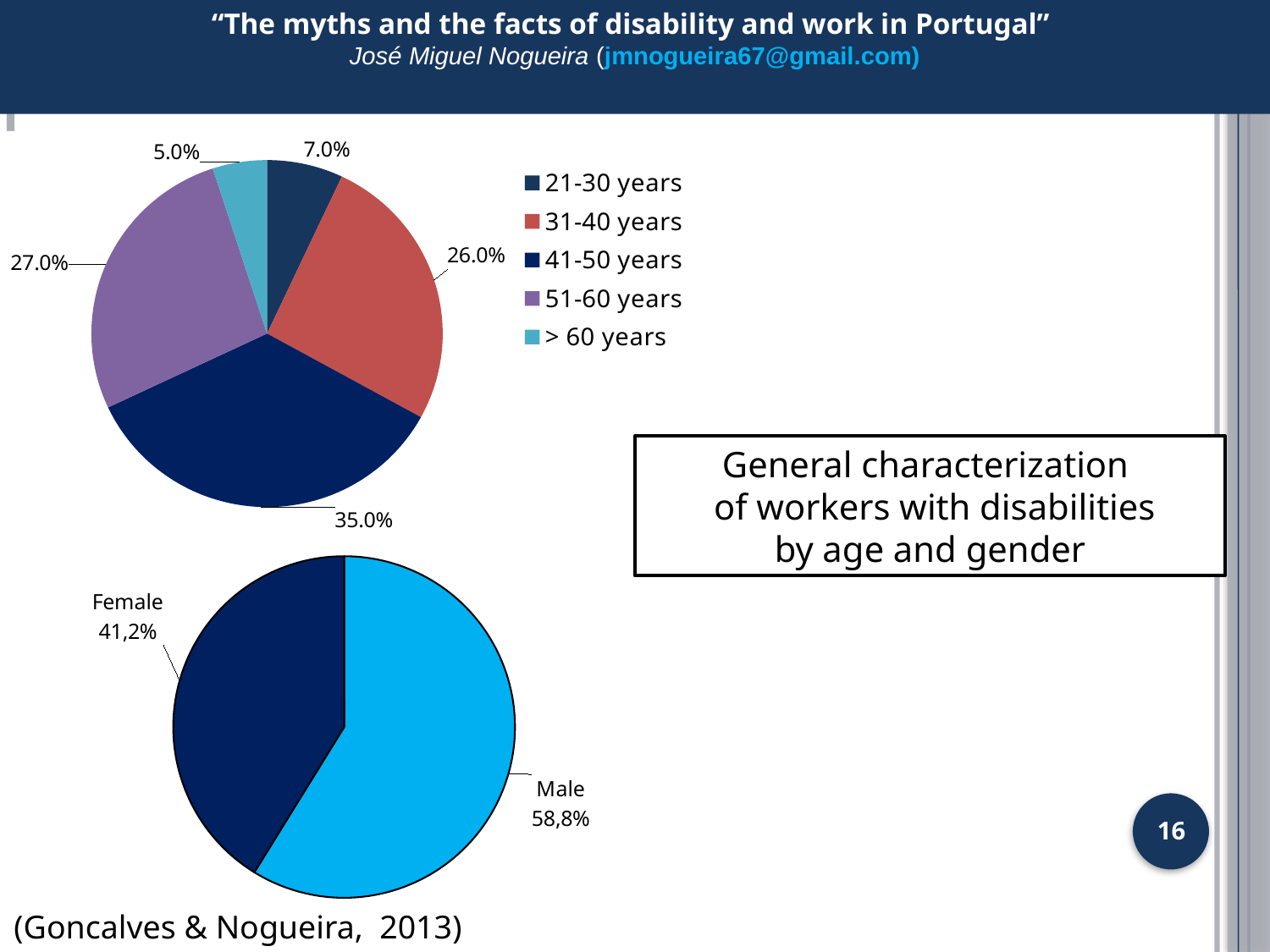
In the top pie chart (by age), which age group has the smallest share? > 60 years How many age groups does the legend of the top pie chart list? 5 In the top pie chart (by age), what share is shown for 41-50 years? 35.0% In the bottom pie chart (by gender), what is the difference between the Male and Female shares? 17,6% In the top pie chart (by age), which is larger: the share for 51-60 years or the share for 31-40 years? 51-60 years In the bottom pie chart (by gender), what share is shown for Male? 58,8% In the top pie chart (by age), what share is shown for > 60 years? 5.0% In the top pie chart (by age), what share is shown for 21-30 years? 7.0% In the top pie chart (by age), which age group has the largest share? 41-50 years In the bottom pie chart (by gender), what share is shown for Female? 41,2% In the top pie chart (by age), what is the difference between the shares for 41-50 years and 31-40 years? 9.0% What type of chart is the bottom chart on the slide? Pie chart